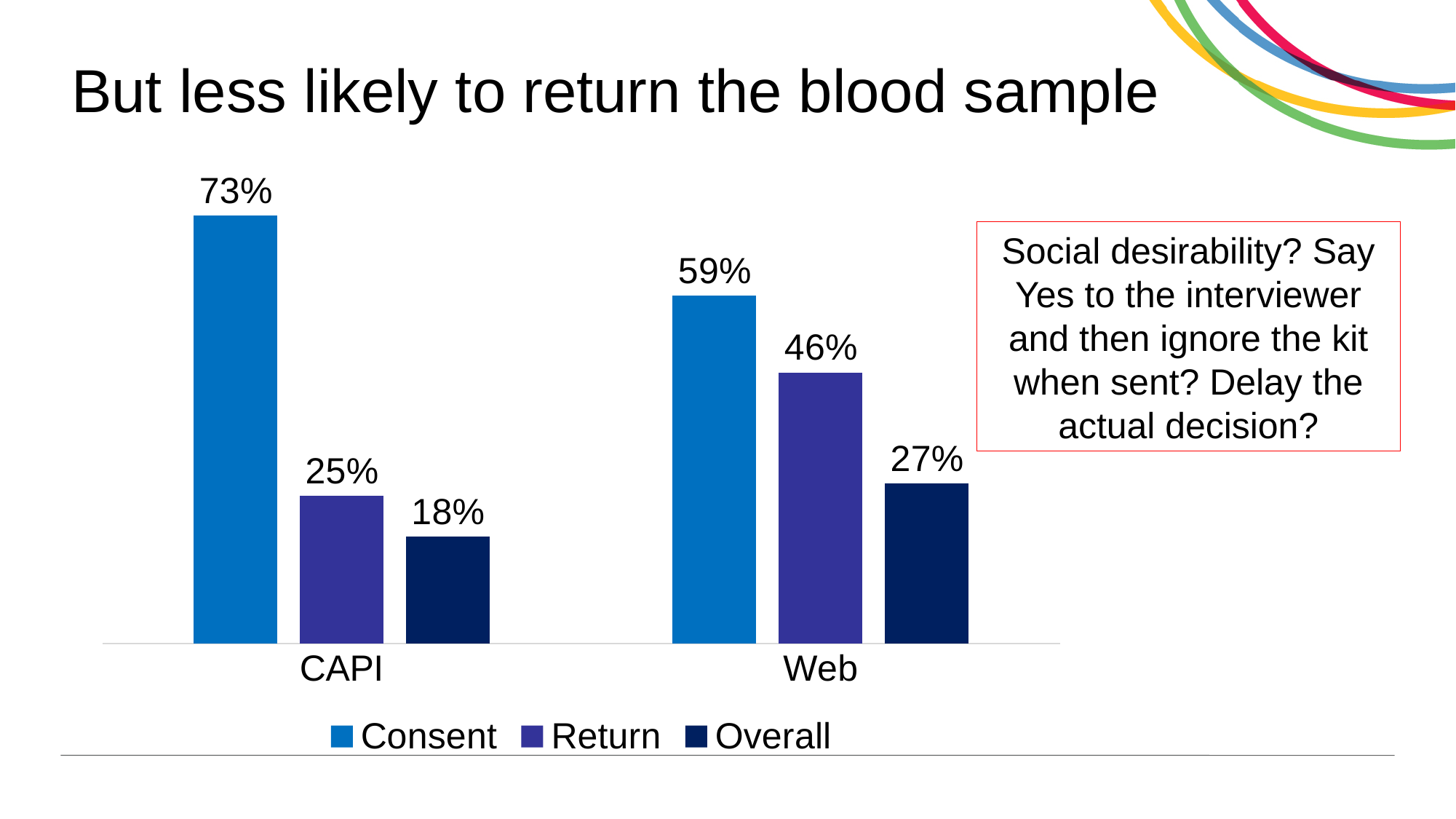
How many series does the legend list? 3 What kind of chart is shown on the slide? Bar chart What is the Consent value for Web? 59% Which category has the highest Consent value? CAPI What is the difference between the Consent and Return values for CAPI? 48% What is the Overall value for CAPI? 18% Which is larger, the Overall value for Web or the Overall value for CAPI? Web Which category has the lowest Overall value? CAPI How many categories are shown on the x axis? 2 What is the Consent value for CAPI? 73% What is the Return value for Web? 46% What is the difference between the Return values for Web and CAPI? 21%